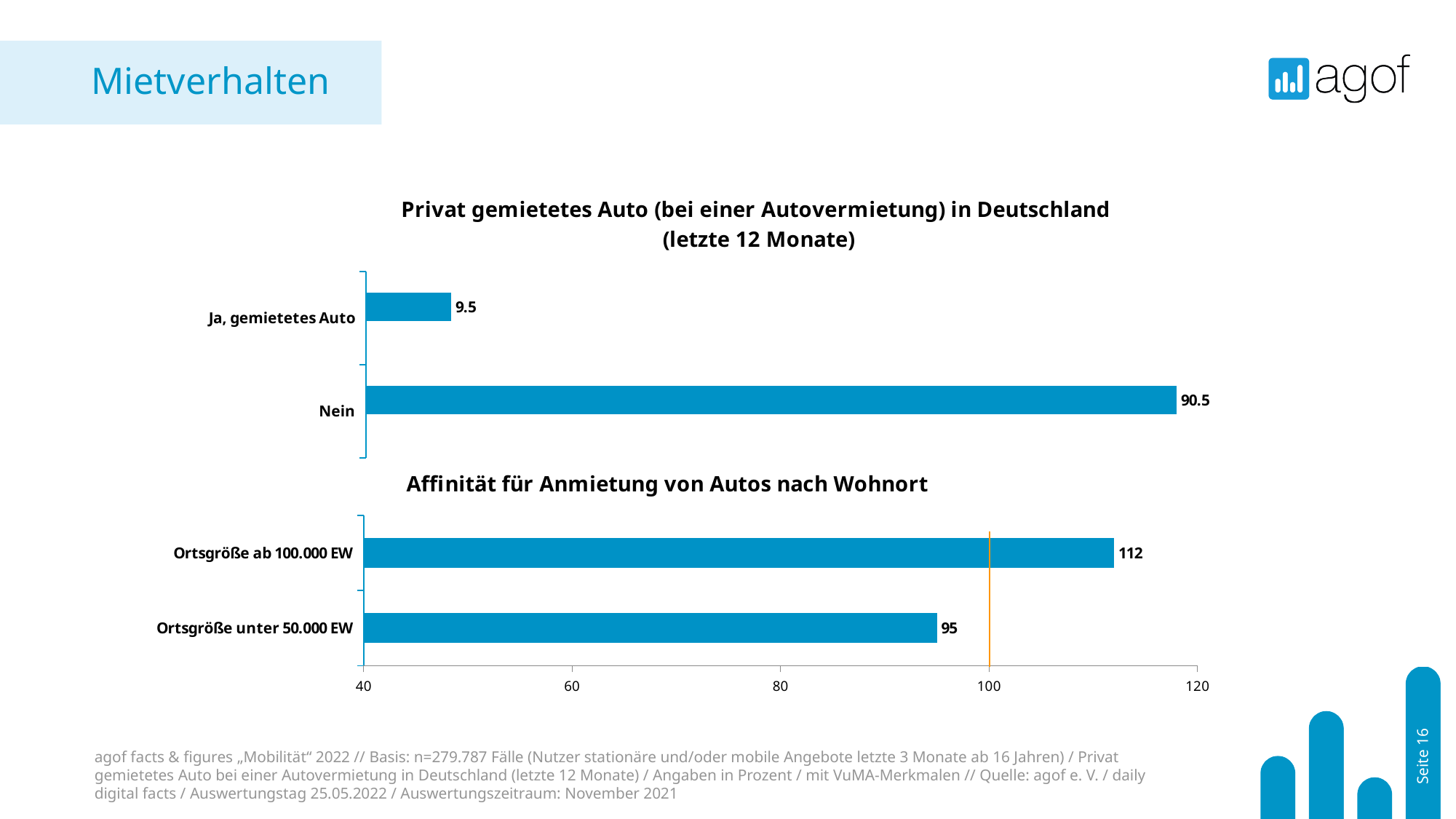
In the top chart, which category has the highest value? Nein In the bottom chart, what is the difference between the values for 'Ortsgröße ab 100.000 EW' and 'Ortsgröße unter 50.000 EW'? 17 In the top chart, what is the difference between the values for 'Nein' and 'Ja, gemietetes Auto'? 81 In the bottom chart, what is the highest value shown on the x axis? 120 In the chart 'Affinität für Anmietung von Autos nach Wohnort', what is the value for 'Ortsgröße unter 50.000 EW'? 95 What kind of chart is the chart 'Affinität für Anmietung von Autos nach Wohnort'? bar chart In the chart 'Privat gemietetes Auto (bei einer Autovermietung) in Deutschland (letzte 12 Monate)', what is the value for 'Nein'? 90.5 In the bottom chart, is the value for 'Ortsgröße unter 50.000 EW' greater or less than 100? less In the chart 'Privat gemietetes Auto (bei einer Autovermietung) in Deutschland (letzte 12 Monate)', what is the value for 'Ja, gemietetes Auto'? 9.5 In the bottom chart, which category has the lowest value? Ortsgröße unter 50.000 EW In the chart 'Affinität für Anmietung von Autos nach Wohnort', what is the value for 'Ortsgröße ab 100.000 EW'? 112 In the top chart, how many categories are shown? 2